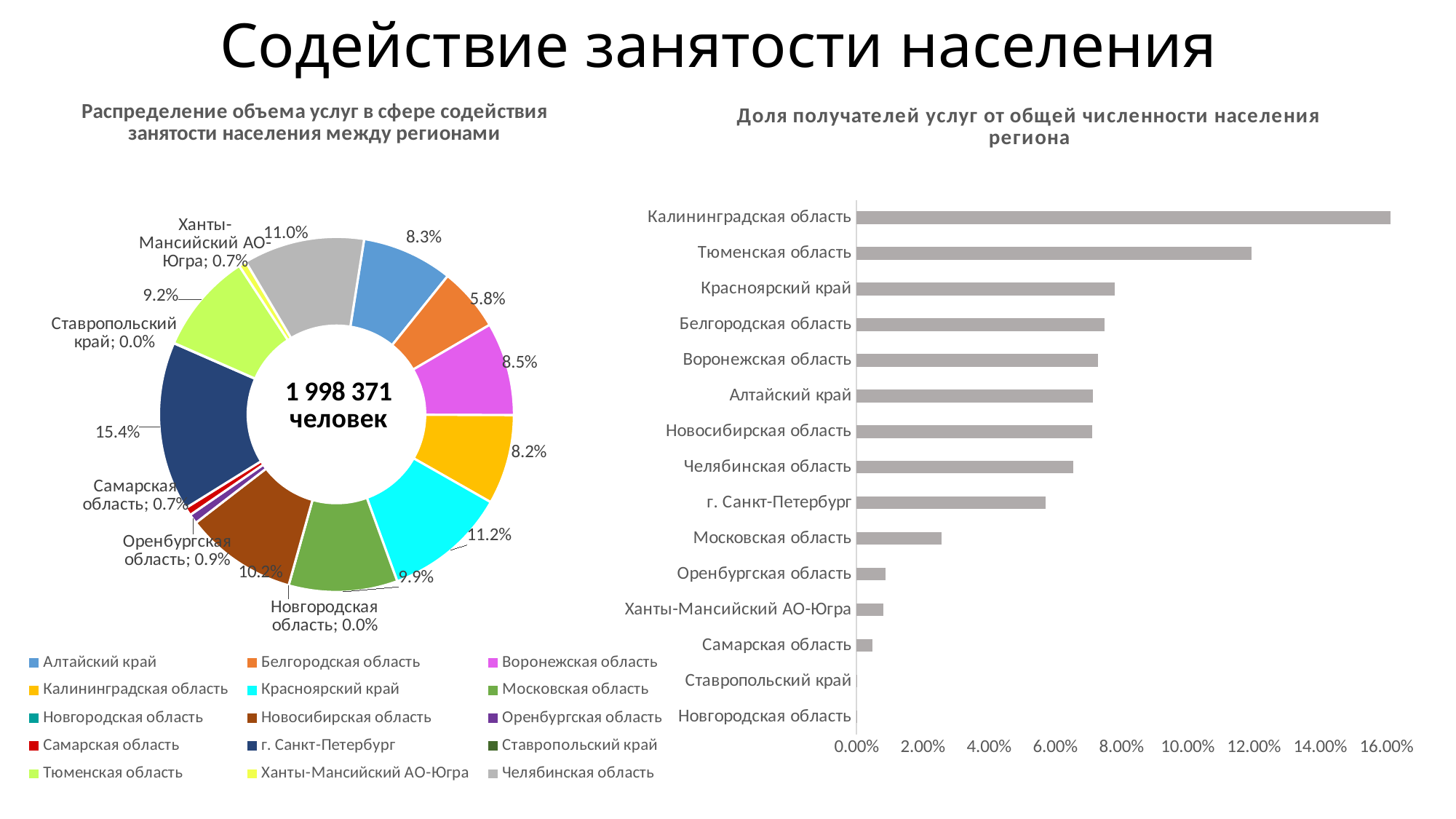
What kind of chart is the right chart, 'Доля получателей услуг от общей численности населения региона'? Bar chart What kind of chart is the left chart, 'Распределение объема услуг в сфере содействия занятости населения между регионами'? Doughnut (pie) chart How many regions are listed in the legend of the left doughnut chart? 15 What total is printed in the centre of the left doughnut chart? 1 998 371 человек In the left doughnut chart, which has the larger share: Алтайский край or Воронежская область? Воронежская область In the right bar chart, which region has the highest share of service recipients? Калининградская область In the left doughnut chart, what share is shown for Красноярский край? 11.2% In the right bar chart, is the value for Московская область greater or less than 4.00%? less In the left doughnut chart, which region has the largest share? г. Санкт-Петербург In the left doughnut chart, what share is shown for г. Санкт-Петербург? 15.4% In the left doughnut chart, what is the difference between the shares of Челябинская область (11.0%) and Тюменская область (9.2%)? 1.8 percentage points In the right bar chart, is the value for Тюменская область greater or less than 10.00%? greater